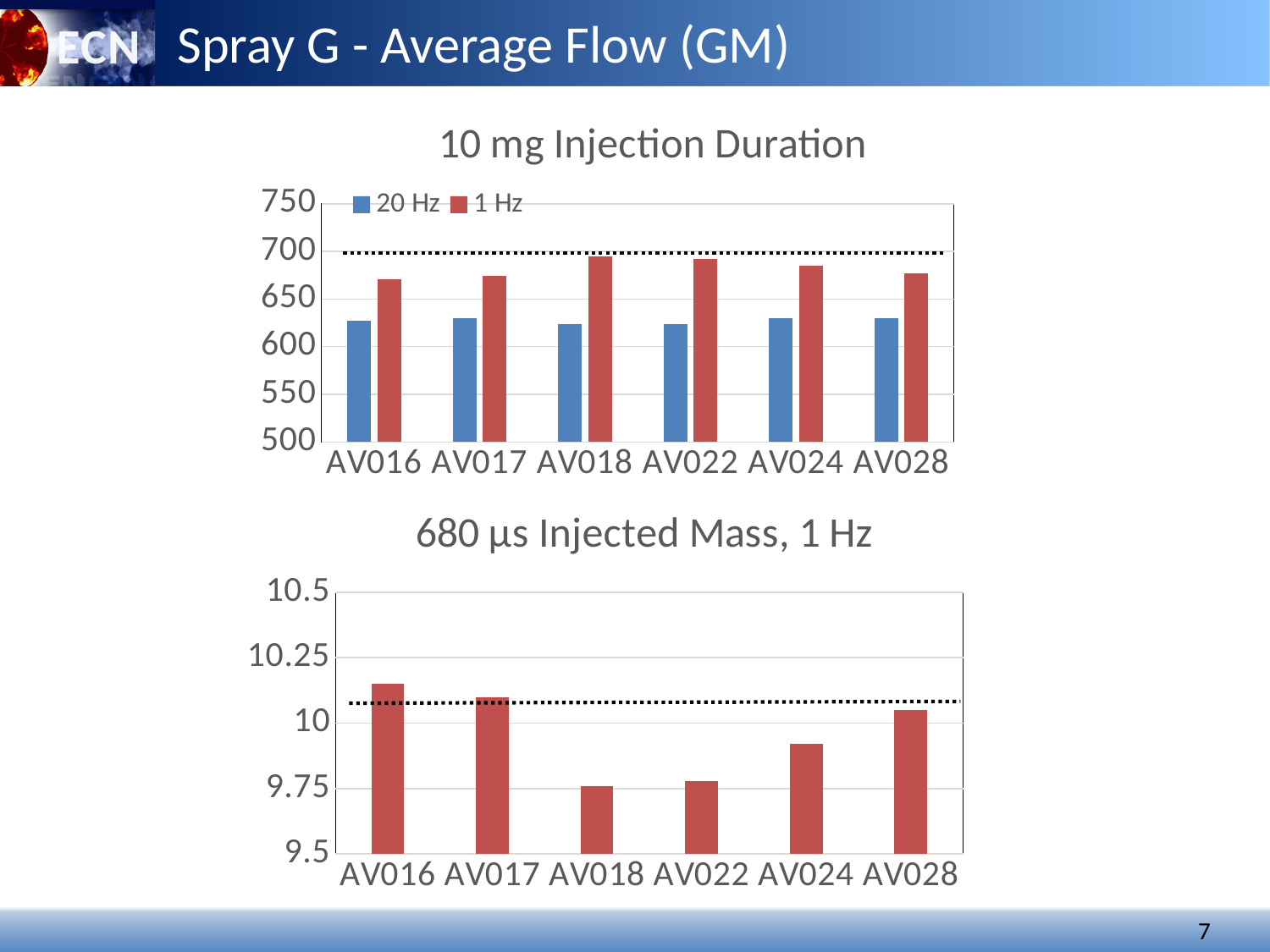
In the '10 mg Injection Duration' chart, which series has the larger value for AV018, 20 Hz or 1 Hz? 1 Hz In the '10 mg Injection Duration' chart, is the 20 Hz value for AV016 greater or less than 650? less In the '680 µs Injected Mass, 1 Hz' chart, which is larger, the value for AV022 or the value for AV024? AV024 What are the series names in the legend of the '10 mg Injection Duration' chart? 20 Hz and 1 Hz How many categories are shown on the x axis of the '10 mg Injection Duration' chart? 6 In the '680 µs Injected Mass, 1 Hz' chart, which category has the highest value? AV016 What is the title of the bottom chart on the slide? 680 µs Injected Mass, 1 Hz In the '680 µs Injected Mass, 1 Hz' chart, is the value for AV024 greater or less than 10? less In the '10 mg Injection Duration' chart, is the 1 Hz value for AV018 greater or less than 650? greater What type of chart is the '10 mg Injection Duration' chart? bar chart How many series does the legend of the '10 mg Injection Duration' chart list? 2